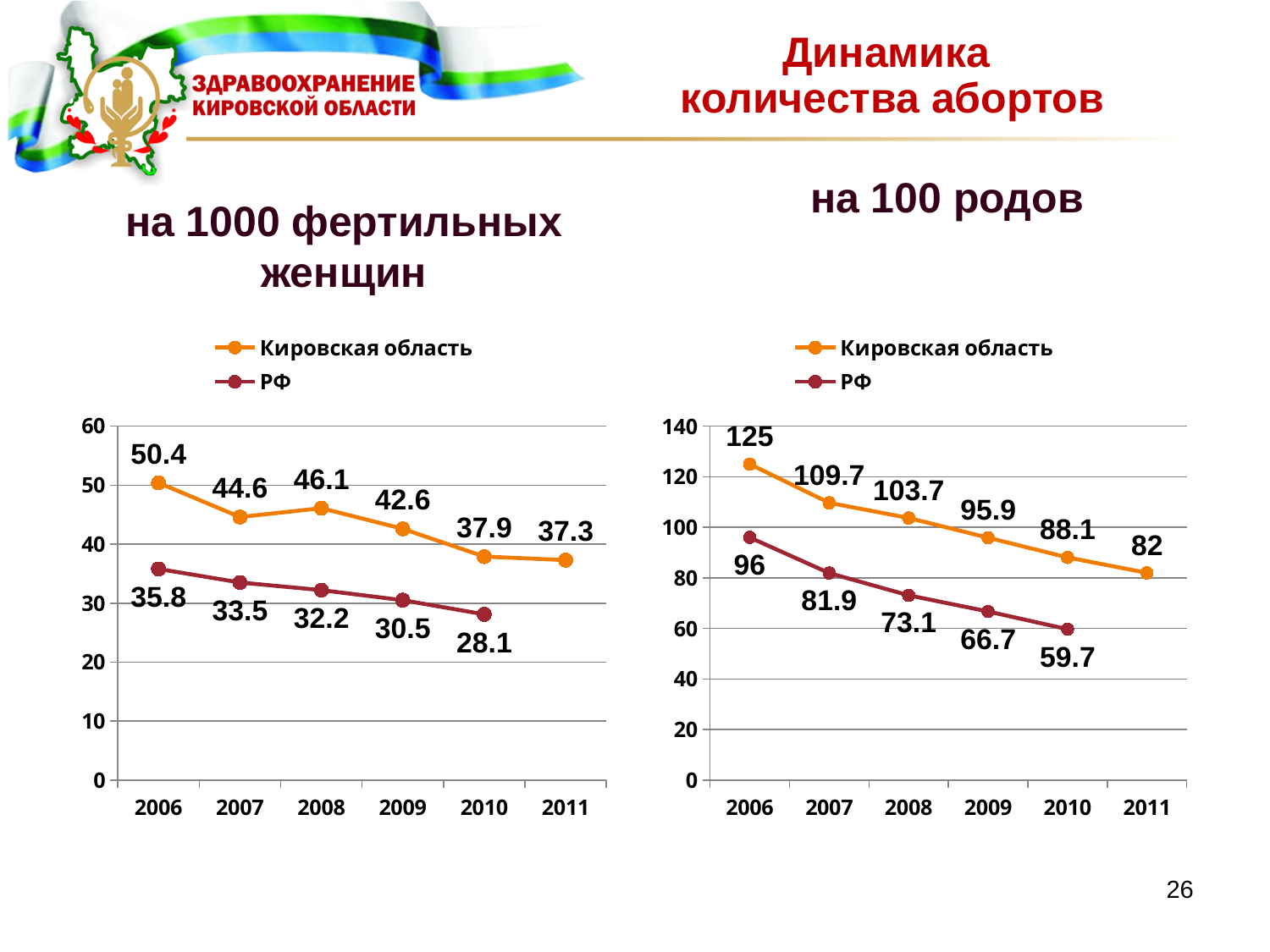
On the chart titled 'на 100 родов', do the РФ values rise or fall from 2006 to 2010? Fall On the chart titled 'на 1000 фертильных женщин', what is the value for РФ in 2010? 28.1 On the chart titled 'на 1000 фертильных женщин', which is larger: the Кировская область value in 2007 or in 2008? 2008 On the chart titled 'на 1000 фертильных женщин', what is the value for Кировская область in 2006? 50.4 On the chart titled 'на 1000 фертильных женщин', in which year is the Кировская область value lowest? 2011 What kind of chart is the chart titled 'на 1000 фертильных женщин'? Line chart On the chart titled 'на 100 родов', what is the value for РФ in 2008? 73.1 On the chart titled 'на 100 родов', what is the difference between the Кировская область values in 2006 and 2011? 43 On the chart titled 'на 100 родов', in which year is the Кировская область value highest? 2006 On the chart titled 'на 1000 фертильных женщин', what is the difference between the Кировская область and РФ values in 2006? 14.6 On the chart titled 'на 100 родов', what is the value for Кировская область in 2011? 82 On the chart titled 'на 100 родов', how many series does the legend list? 2